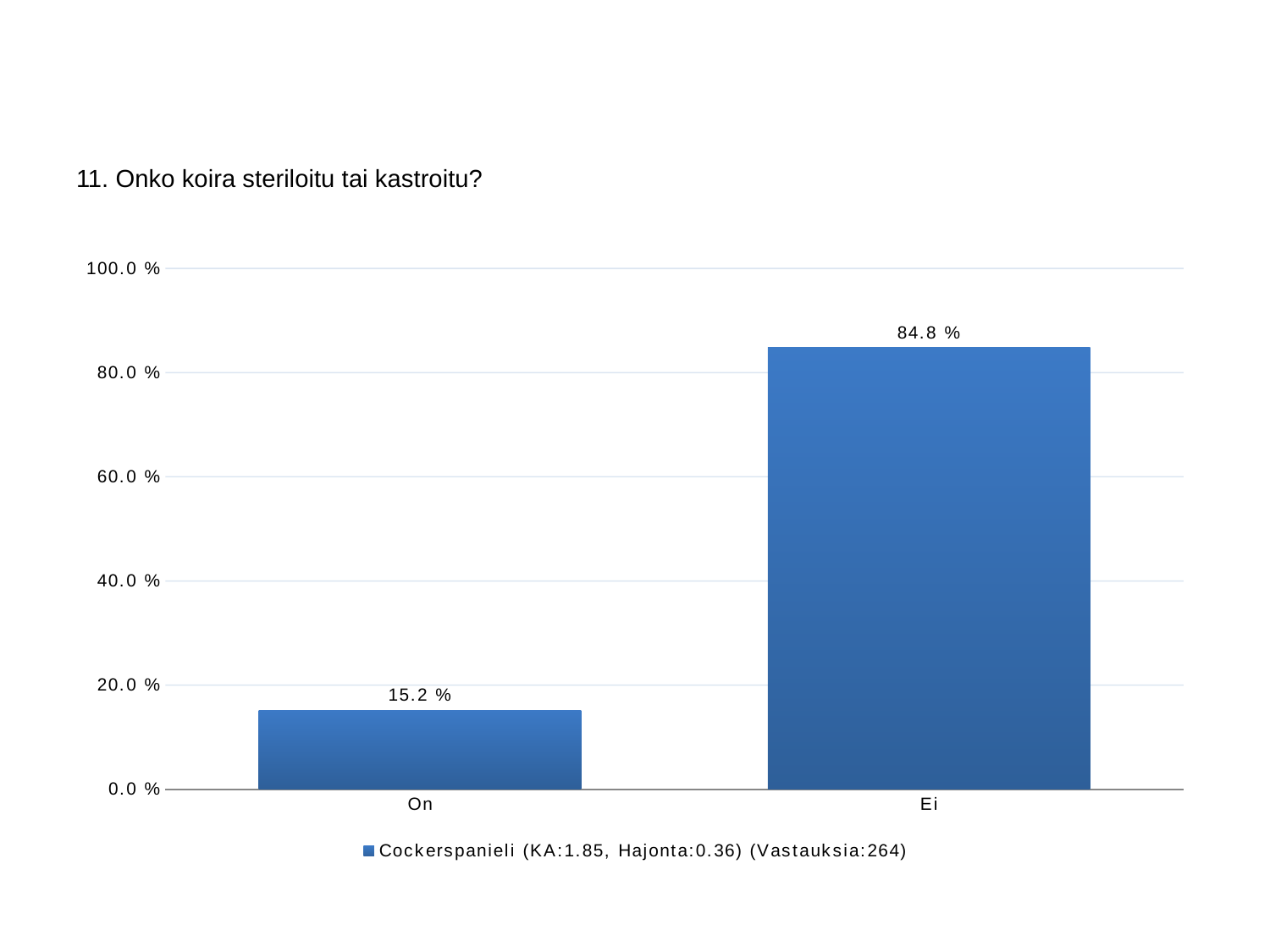
What kind of chart is shown on the slide? bar chart What is the value for "On"? 15.2 % Is the value for "On" greater or less than 20.0 %? less Is the value for "Ei" greater or less than 80.0 %? greater Which category has the highest value? Ei What is the difference between the values for "Ei" and "On"? 69.6 % Which is larger, the value for "On" or the value for "Ei"? Ei What is the title of the chart? 11. Onko koira steriloitu tai kastroitu? How many series does the legend list? 1 How many categories are shown on the x axis? 2 Which category has the lowest value? On What is the value for "Ei"? 84.8 %